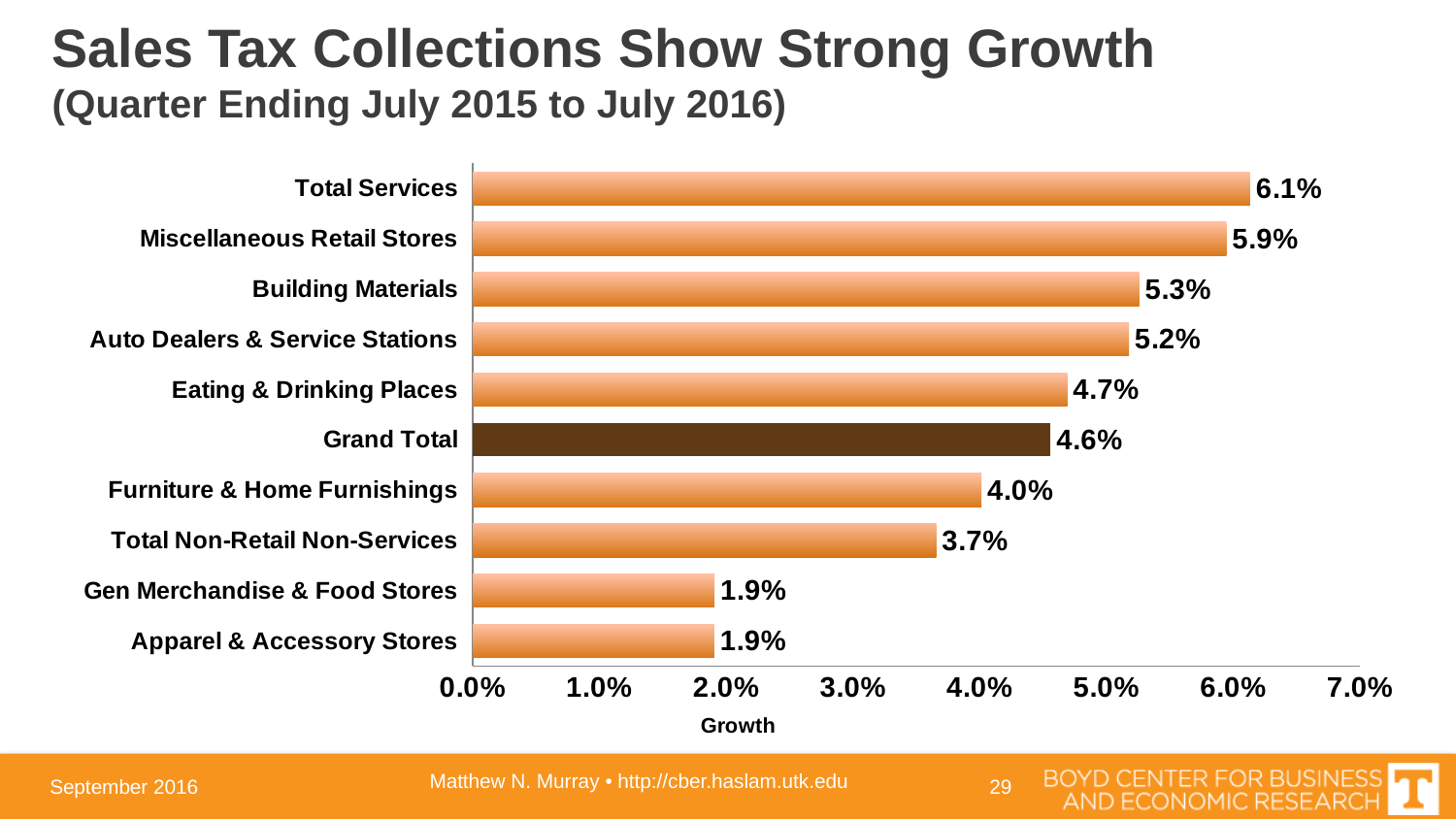
What kind of chart is shown on the slide? Bar chart What is the lowest growth value shown on the chart? 1.9% Which bar is shown in a darker colour than the others? Grand Total What is the label of the horizontal axis? Growth What is the growth value for Eating & Drinking Places? 4.7% How many categories are shown on the chart? 10 Which has higher growth, Furniture & Home Furnishings or Total Non-Retail Non-Services? Furniture & Home Furnishings Which category has the highest growth? Total Services What is the growth value for Total Services? 6.1% Is the growth value for Auto Dealers & Service Stations greater or less than 5.0%? greater What is the difference in growth between Miscellaneous Retail Stores and Building Materials? 0.6% What is the growth value for Grand Total? 4.6%